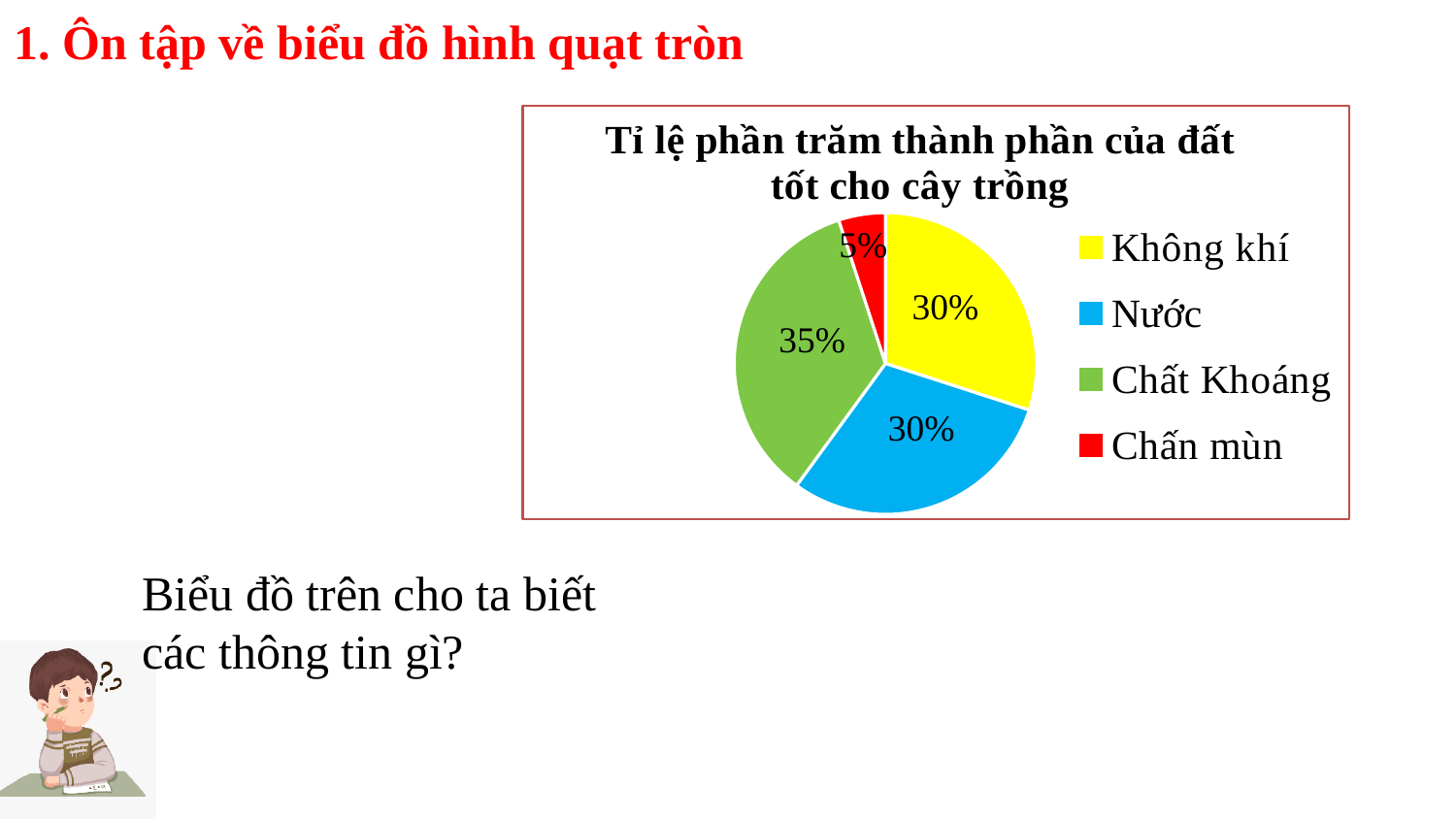
What percentage does the Không khí slice represent? 30% What percentage does the Chất Khoáng slice represent? 35% What is the title of the pie chart? Tỉ lệ phần trăm thành phần của đất tốt cho cây trồng What is the difference between the Chất Khoáng share and the Chấn mùn share? 30% Which component has the largest share of the pie? Chất Khoáng What kind of chart is shown on the slide? pie chart Which component has the smallest share of the pie? Chấn mùn Which colour represents Nước in the legend? blue Which is larger, the share for Chất Khoáng or the share for Nước? Chất Khoáng What percentage does the Nước slice represent? 30% How many slices does the pie chart have? 4 What percentage does the Chấn mùn slice represent? 5%